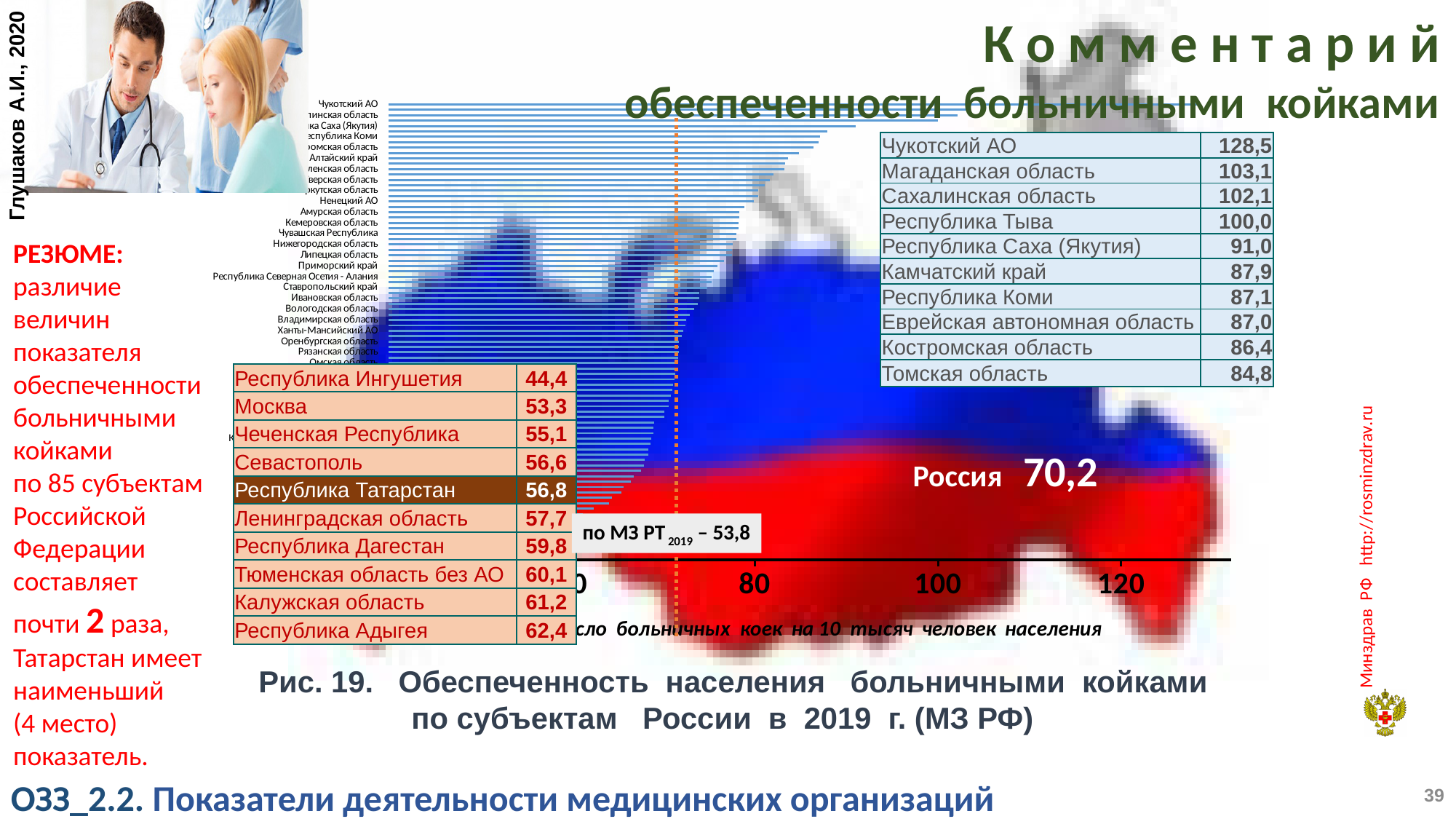
What is the difference between the values for Чукотский АО and Республика Ингушетия? 84,1 What is the value shown for Россия? 70,2 Which region has the highest value? Чукотский АО What is the figure number given in the chart caption? Рис. 19 Which region has the lowest value? Республика Ингушетия What is the value for Москва? 53,3 Is the value for Чукотский АО greater or less than 120? greater What is the difference between the value for Россия and the value for Республика Татарстан? 13,4 Which has a larger value, Магаданская область or Сахалинская область? Магаданская область What is the value for Республика Татарстан? 56,8 What is the value for Чукотский АО? 128,5 What type of chart is shown on the slide? bar chart